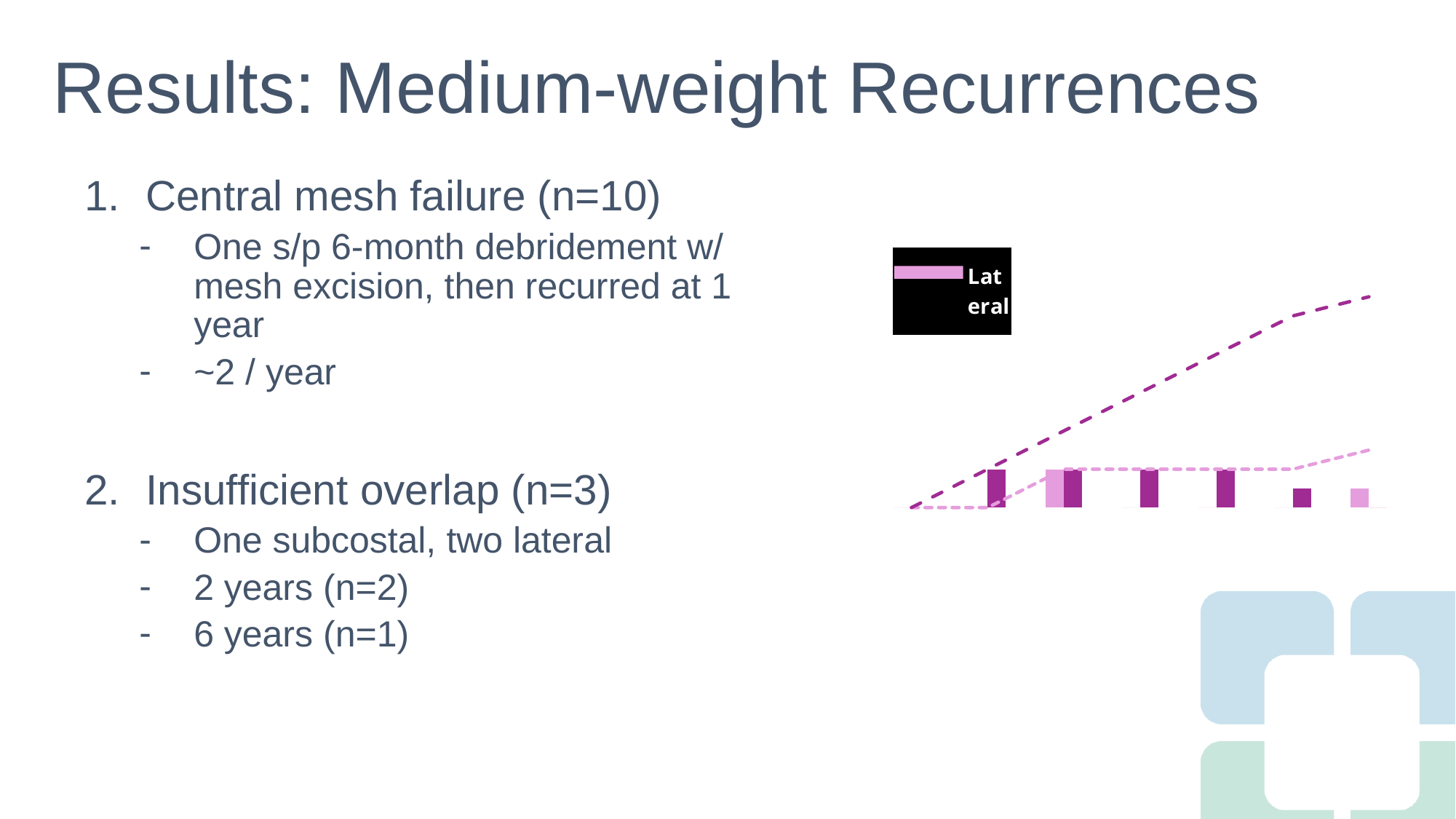
How many light pink bars are plotted in the chart? 2 How many bars in total are plotted in the chart? 7 How many dark magenta bars are plotted in the chart? 5 What kind of chart is shown on the right side of the slide? combination bar and line chart What colour is the Lateral series in the chart's legend? light pink What series name is shown in the chart's legend? Lateral Does the dark magenta dashed line rise or fall from left to right across the chart? rise Which is taller in the chart, the leftmost light pink bar or the rightmost light pink bar? the leftmost light pink bar Which is taller in the chart, the leftmost dark magenta bar or the rightmost dark magenta bar? the leftmost dark magenta bar